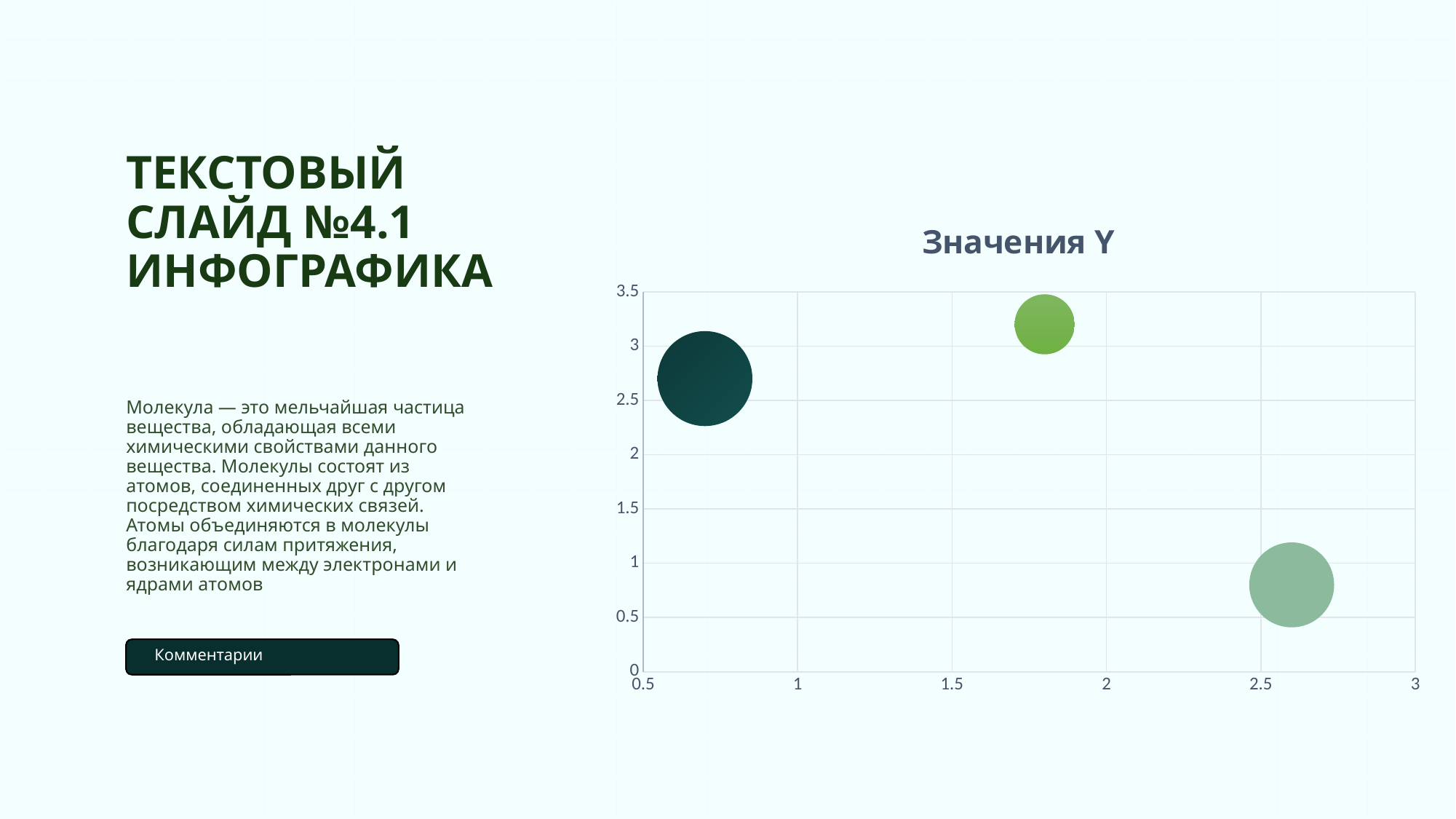
What kind of chart is shown on the slide? bubble chart Which bubble is drawn largest on the chart? the dark teal one Is the y value of the pale green bubble greater or less than 1.5? less Is the x value of the dark teal bubble greater or less than 1? less Is the x value of the pale green bubble greater or less than 2? greater Which bubble has the lowest y value: the dark teal, the bright green, or the pale green one? the pale green one How many bubbles are plotted on the chart? 3 What is the title of the chart? Значения Y Which bubble has the highest y value: the dark teal, the bright green, or the pale green one? the bright green one Which bubble has the larger y value, the dark teal one or the pale green one? the dark teal one